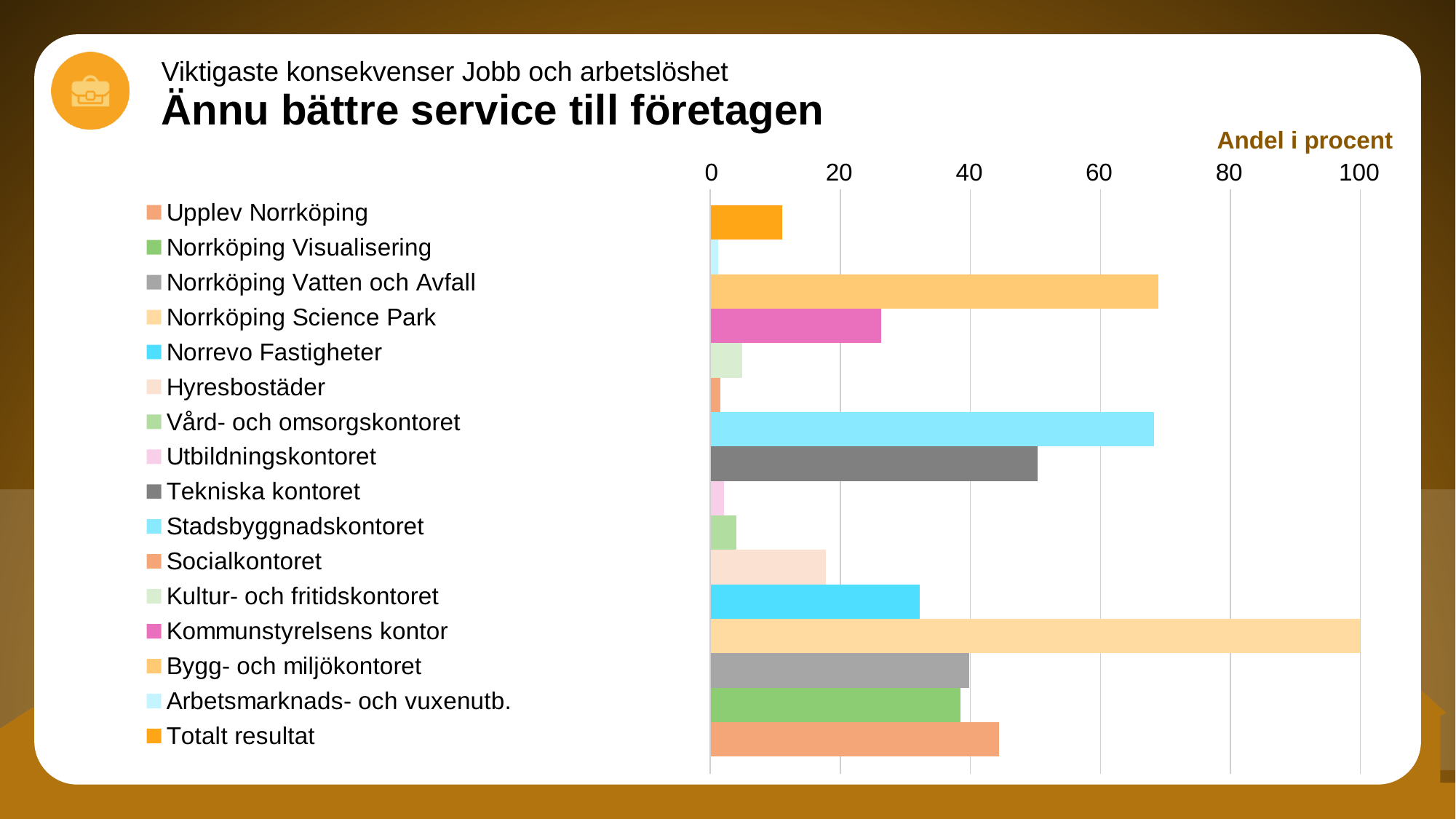
What label is shown above the horizontal axis of the chart? Andel i procent Is the value for Hyresbostäder greater or less than 20? less Which is larger, the value for Tekniska kontoret or the value for Norrevo Fastigheter? Tekniska kontoret Is the value for Stadsbyggnadskontoret greater or less than 60? greater Which category has the highest value in the chart? Norrköping Science Park Is the value for Bygg- och miljökontoret greater or less than 60? greater What kind of chart is shown on the slide? bar chart What is the value for Norrköping Science Park? 100 How many categories does the legend of the chart list? 16 Which is larger, the value for Bygg- och miljökontoret or the value for Kommunstyrelsens kontor? Bygg- och miljökontoret